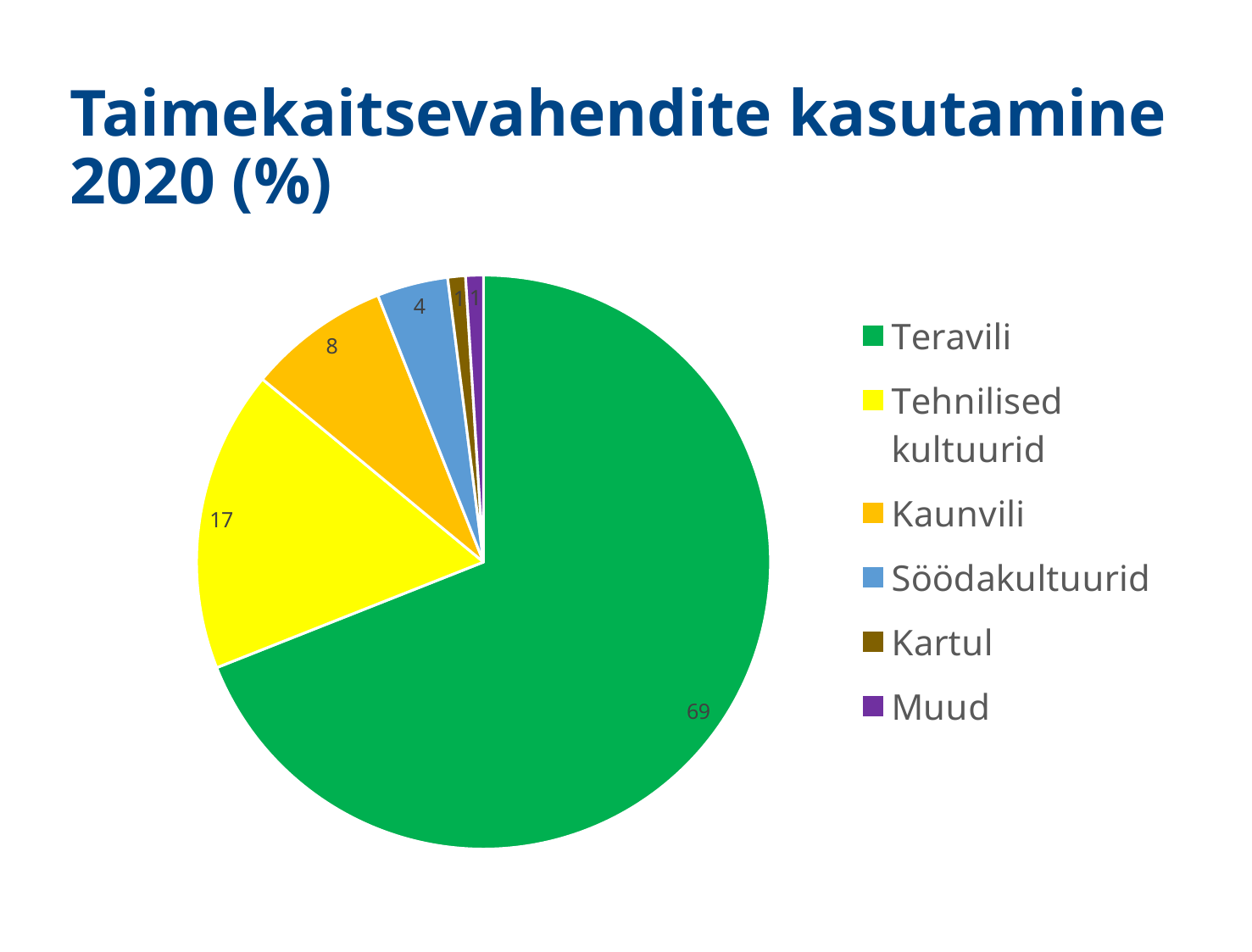
What is the title of the chart on the slide? Taimekaitsevahendite kasutamine 2020 (%) Which category has the largest slice of the pie? Teravili What is the value for Söödakultuurid? 4 What is the value for Kartul? 1 What is the value for Kaunvili? 8 What is the difference between the values for Teravili and Tehnilised kultuurid? 52 Which colour represents Muud in the legend? purple What kind of chart is shown on the slide? pie chart What is the value for Teravili? 69 How many categories does the pie chart show? 6 What is the value for Tehnilised kultuurid? 17 Which is larger, the value for Kaunvili or the value for Söödakultuurid? Kaunvili